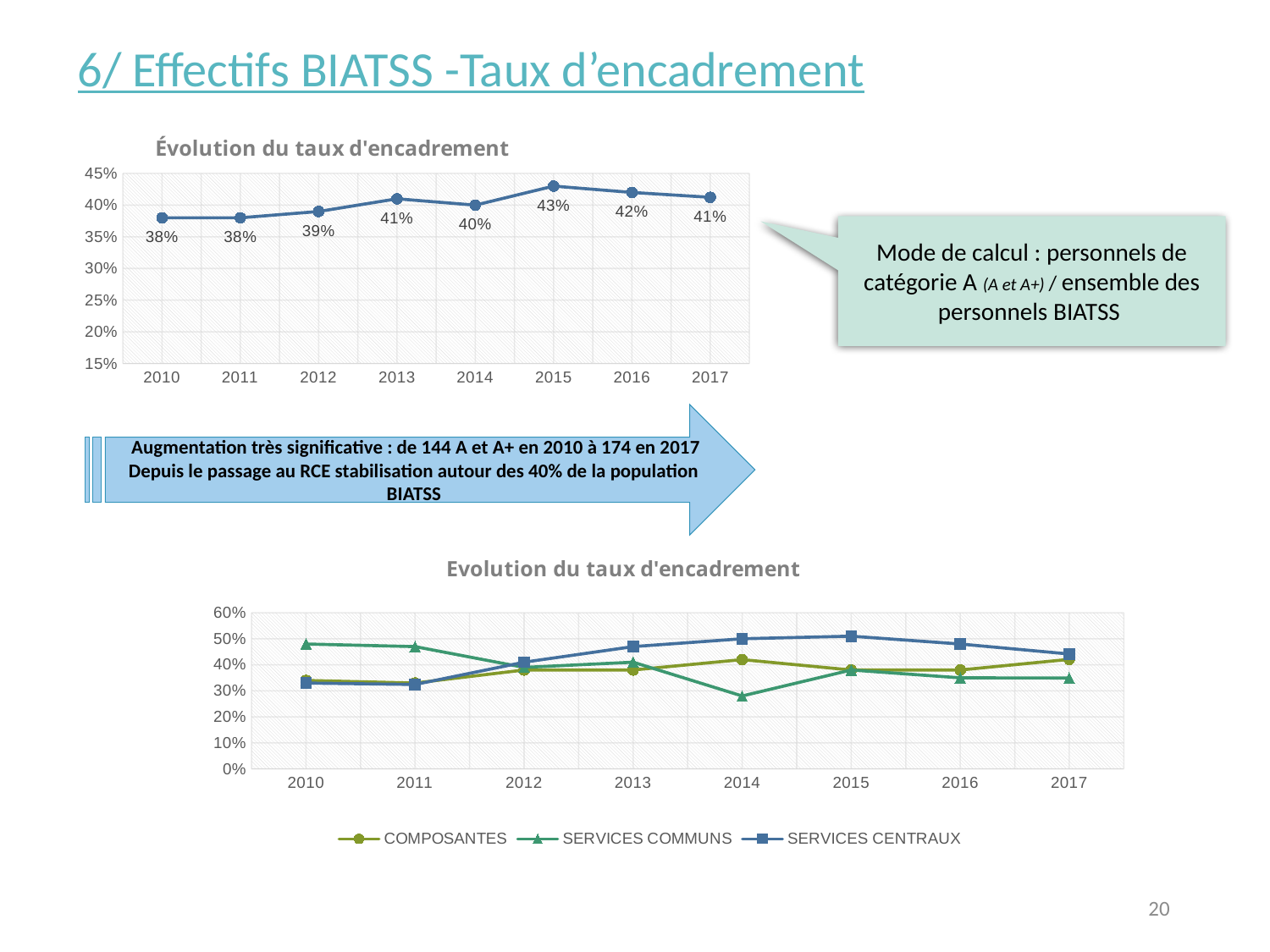
In the top chart 'Évolution du taux d'encadrement', how many years are plotted on the x axis? 8 In the top chart 'Évolution du taux d'encadrement', which is larger, the value for 2013 or the value for 2014? 2013 In the top chart 'Évolution du taux d'encadrement', what is the value for 2015? 43% In the bottom chart 'Evolution du taux d'encadrement', is the value for SERVICES COMMUNS in 2014 greater or less than 30%? less In the top chart 'Évolution du taux d'encadrement', does the value rise or fall from 2010 to 2015? Rise In the top chart 'Évolution du taux d'encadrement', what is the difference between the 2015 value and the 2010 value? 5% In the bottom chart 'Evolution du taux d'encadrement', how many series does the legend list? 3 In the top chart 'Évolution du taux d'encadrement', which year has the highest value? 2015 In the bottom chart 'Evolution du taux d'encadrement', is the value for SERVICES CENTRAUX in 2015 greater or less than 40%? greater What type of chart is the top chart 'Évolution du taux d'encadrement'? Line chart In the bottom chart 'Evolution du taux d'encadrement', which series has the highest value in 2010? SERVICES COMMUNS In the top chart 'Évolution du taux d'encadrement', what is the value for 2010? 38%